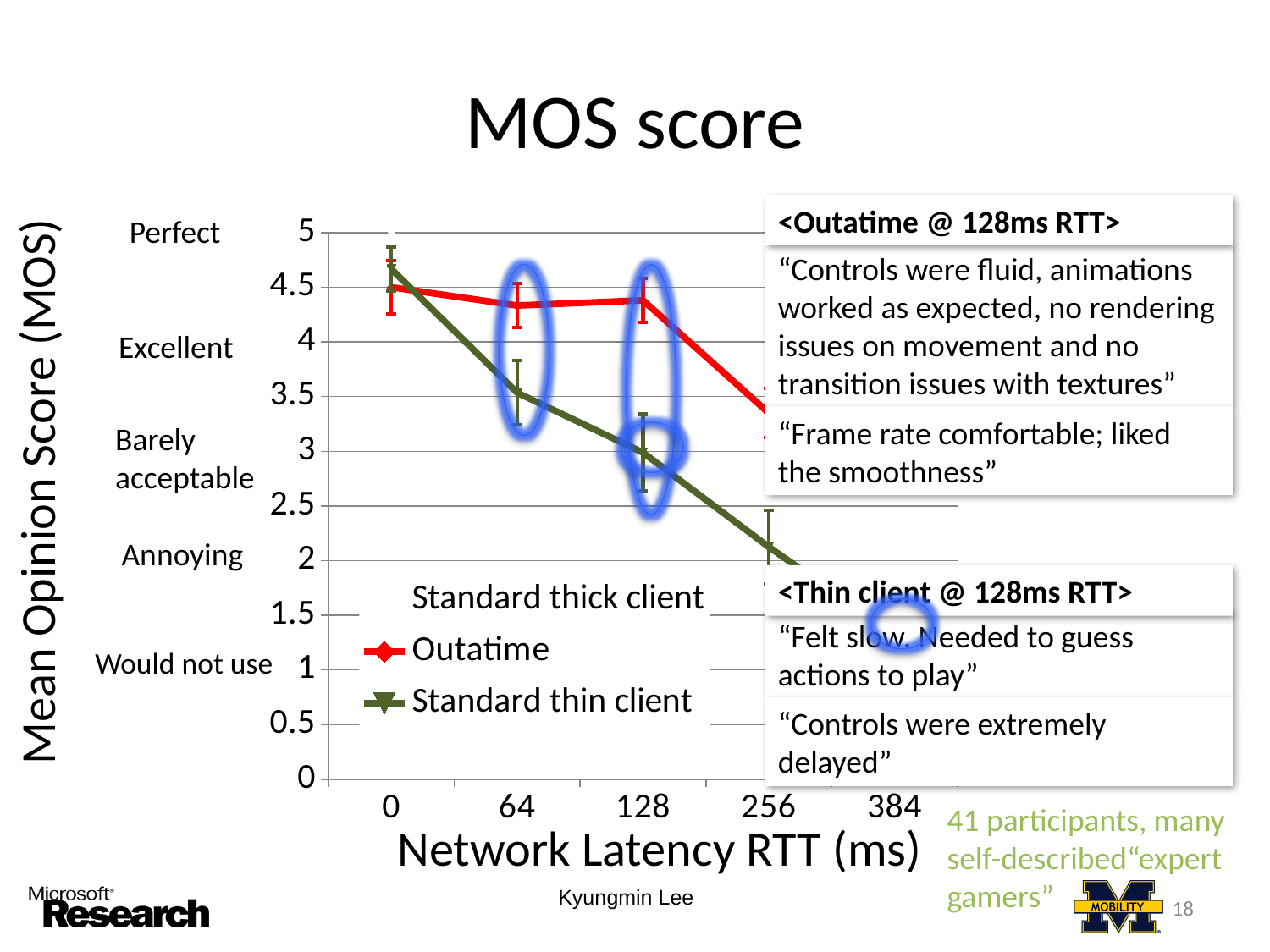
Is the Standard thin client value at 128 ms RTT greater or less than 3.5? less How many latency values are labelled on the x axis? 5 Does the Standard thin client MOS rise or fall as network latency increases? fall What is the title of the x axis? Network Latency RTT (ms) What colour is the Outatime line? red Is the Outatime value at 128 ms RTT greater or less than 4? greater Is the Outatime value at 64 ms RTT greater or less than 4? greater How many series does the chart legend list? 3 At 128 ms RTT, which series has the higher MOS: Outatime or Standard thin client? Outatime What kind of chart is shown on the slide? line chart